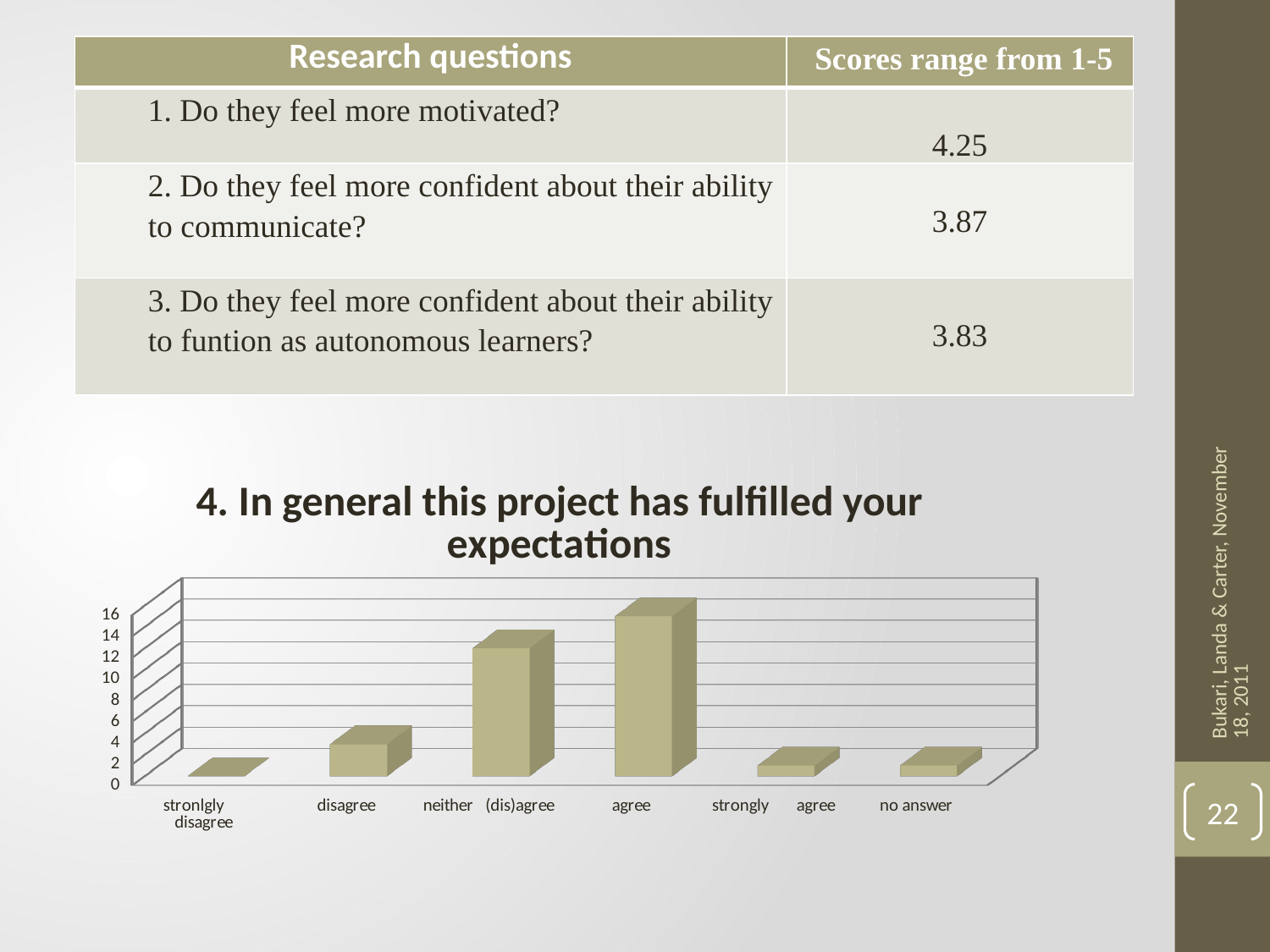
Is the value for disagree greater or less than 6? less Which category has the highest value in the chart? agree Do the values rise or fall from strongly disagree to agree along the x axis? rise Is the value for strongly agree greater or less than 4? less Is the value for agree greater or less than 12? greater Which is larger, the value for agree or the value for disagree? agree How many categories are shown on the x axis of the chart? 6 Which category has the lowest value in the chart? strongly disagree What kind of chart is shown on the slide? bar chart What is the title of the chart? 4. In general this project has fulfilled your expectations